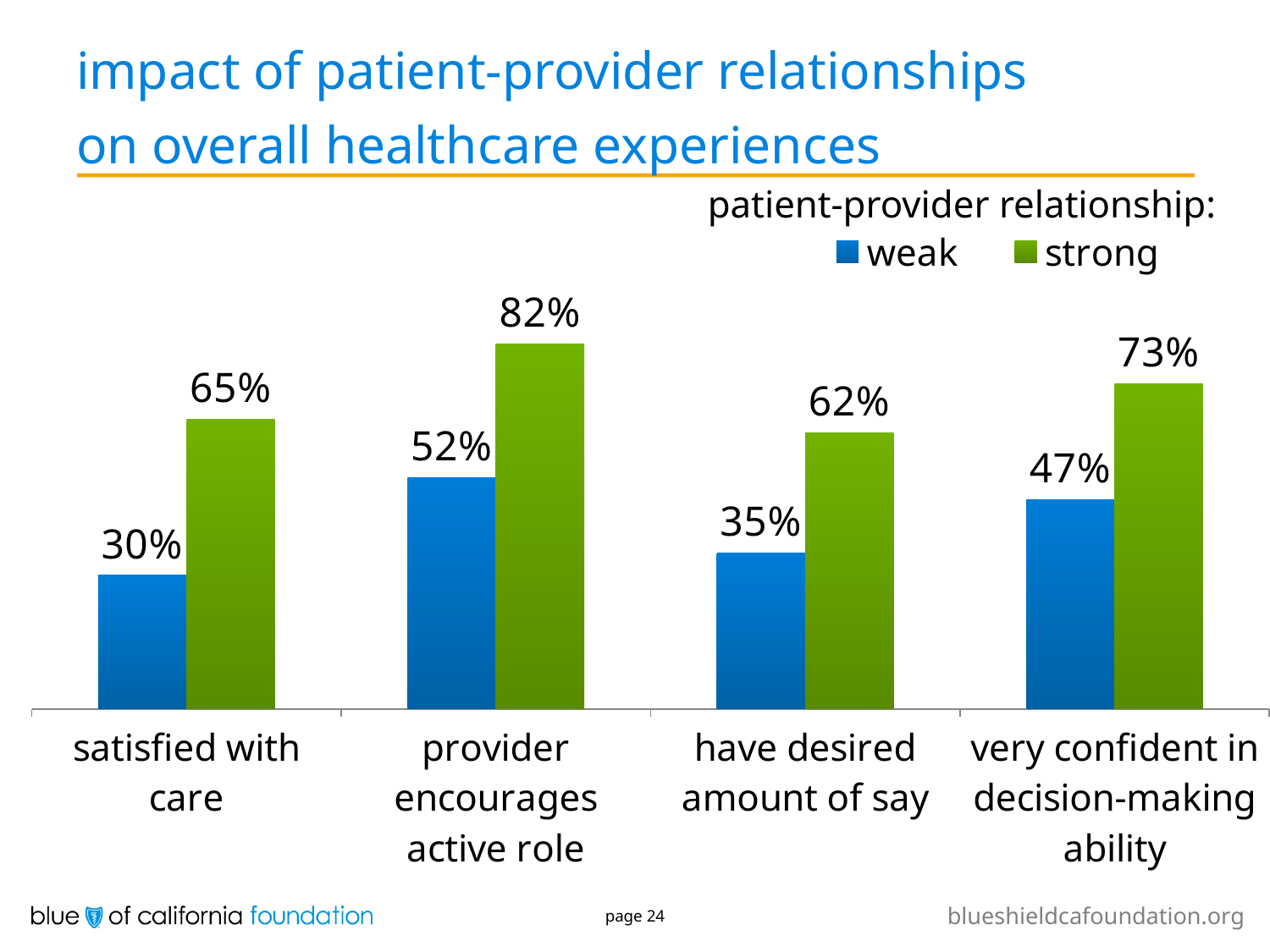
What is the value for 'weak' in the 'have desired amount of say' category? 35% What is the value for 'strong' in the 'provider encourages active role' category? 82% How many categories are shown on the x axis? 4 Which category has the lowest value for the 'weak' series? satisfied with care Which is larger: the 'weak' value for 'provider encourages active role' or the 'weak' value for 'very confident in decision-making ability'? provider encourages active role How many series does the legend list? 2 What is the difference between the 'strong' and 'weak' values in the 'have desired amount of say' category? 27% Which category has the highest value for the 'strong' series? provider encourages active role What is the value for 'strong' in the 'very confident in decision-making ability' category? 73% What is the difference between the 'strong' and 'weak' values in the 'satisfied with care' category? 35% What is the value for 'weak' in the 'satisfied with care' category? 30% What kind of chart is shown on the slide? bar chart